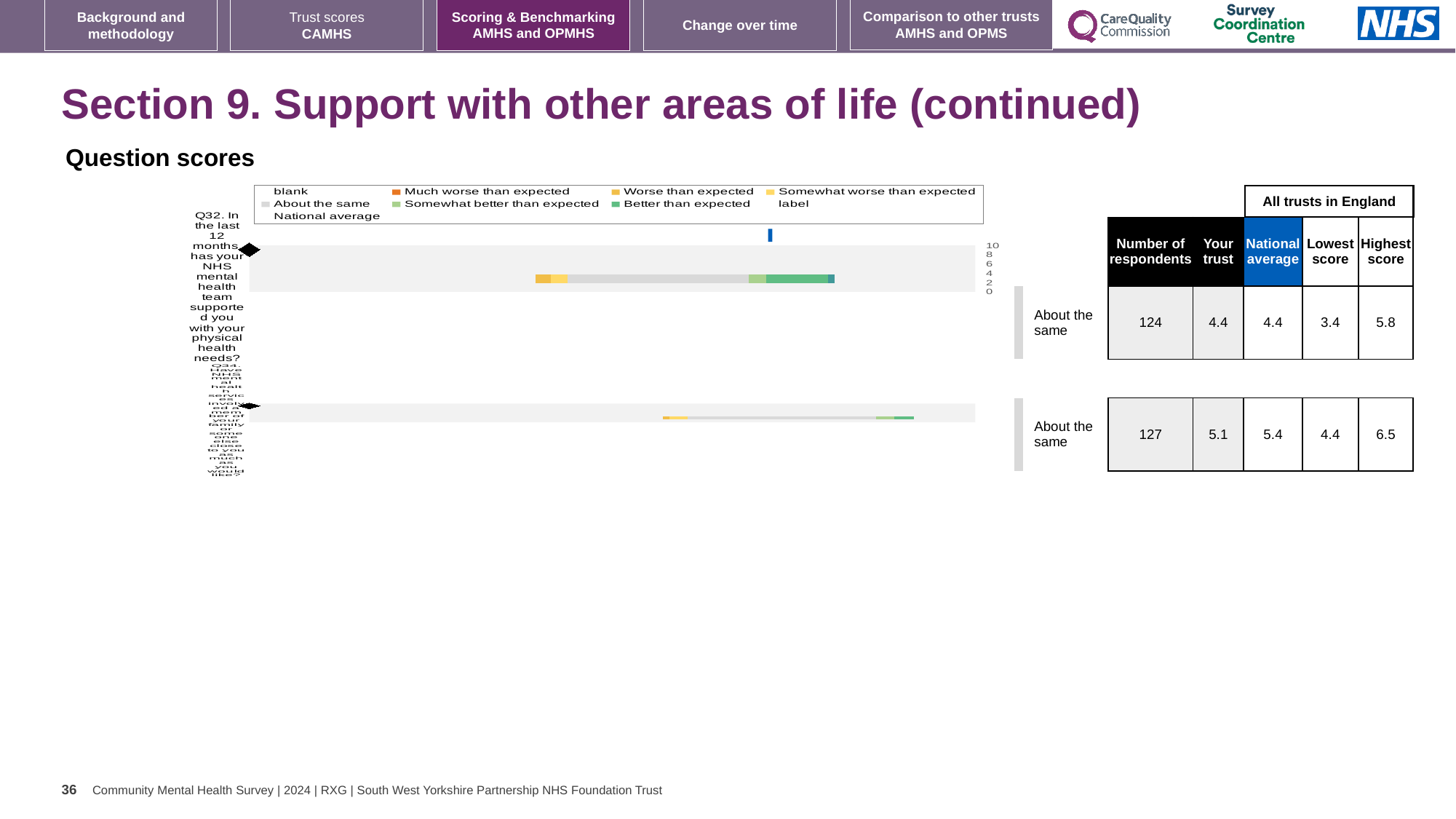
In the table next to the chart, what is the national average for Q32? 4.4 Which legend entry is shown in dark green in the question scores chart? Better than expected In the table next to the chart, what is the highest score for Q34? 6.5 In the table next to the chart, what is the 'Your trust' score for Q34? 5.1 What kind of chart is used to show the question scores on this slide? bar chart In the table next to the chart, what is the lowest score for Q32? 3.4 In the table next to the chart, how many respondents are listed for Q32? 124 For Q34, which is larger: the 'Your trust' score or the national average? National average How many more respondents are listed for Q34 than for Q32? 3 How many questions (categories) are plotted in the question scores chart? 2 What is the highest value shown on the chart's numeric axis? 10 What is the difference between the highest score and the lowest score for Q32? 2.4